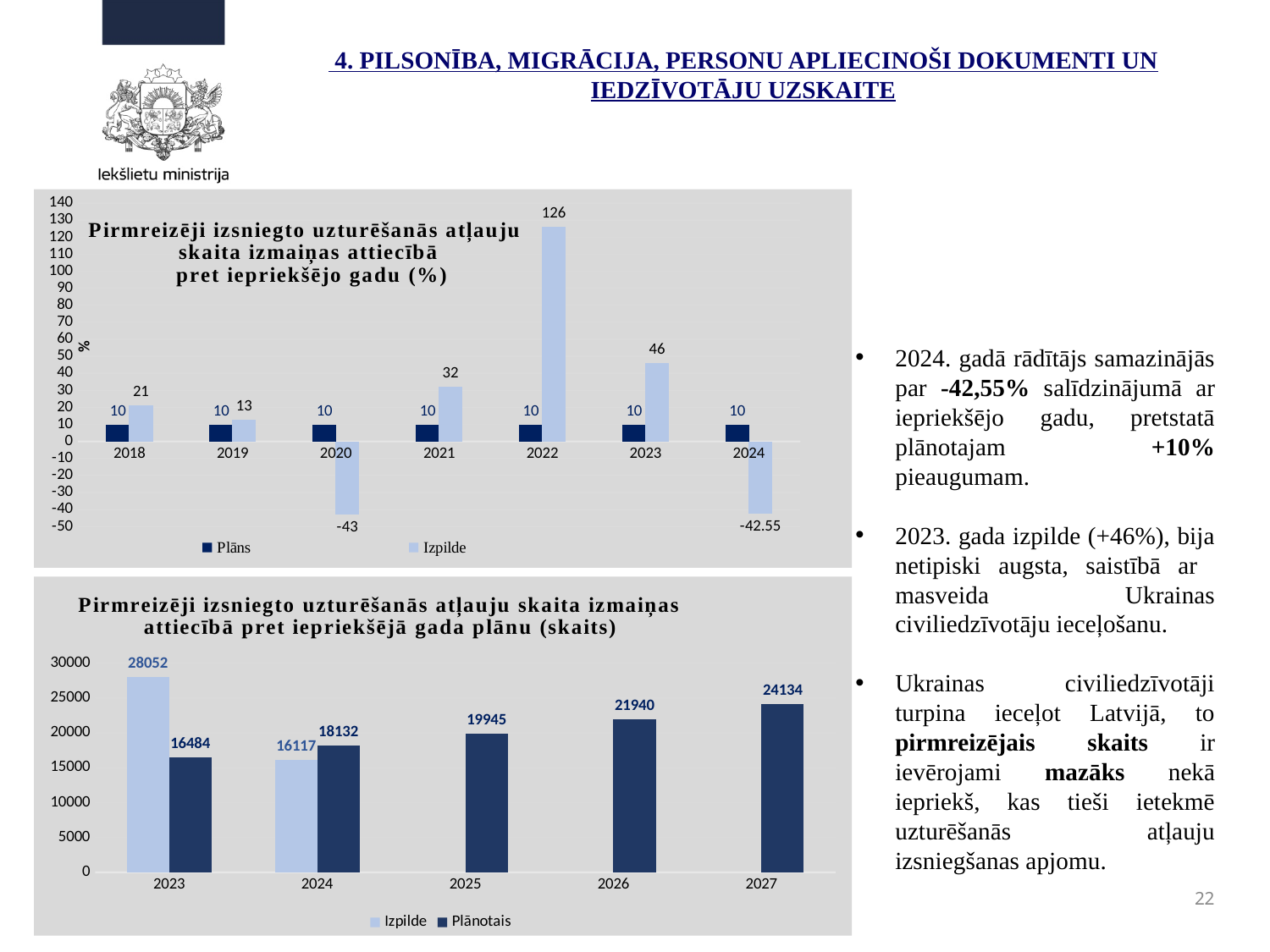
In the bottom chart, what is the difference between the Izpilde and Plānotais values for 2024? 2015 In the top chart, how many years are shown on the x axis? 7 In the top chart, what is the Izpilde value for 2022? 126 In the top chart, how many series does the legend list? 2 In the top chart, what is the difference between the Izpilde value for 2023 and the Plāns value for 2023? 36 In the top chart, which year has the highest Izpilde value? 2022 What kind of chart is the bottom chart? bar chart In the bottom chart, what is the Izpilde value for 2023? 28052 In the bottom chart, do the Plānotais values rise or fall from 2023 to 2027? rise In the top chart, what is the Izpilde value for 2024? -42.55 In the top chart, which year has the lowest Izpilde value? 2020 In the bottom chart, what is the Plānotais value for 2027? 24134